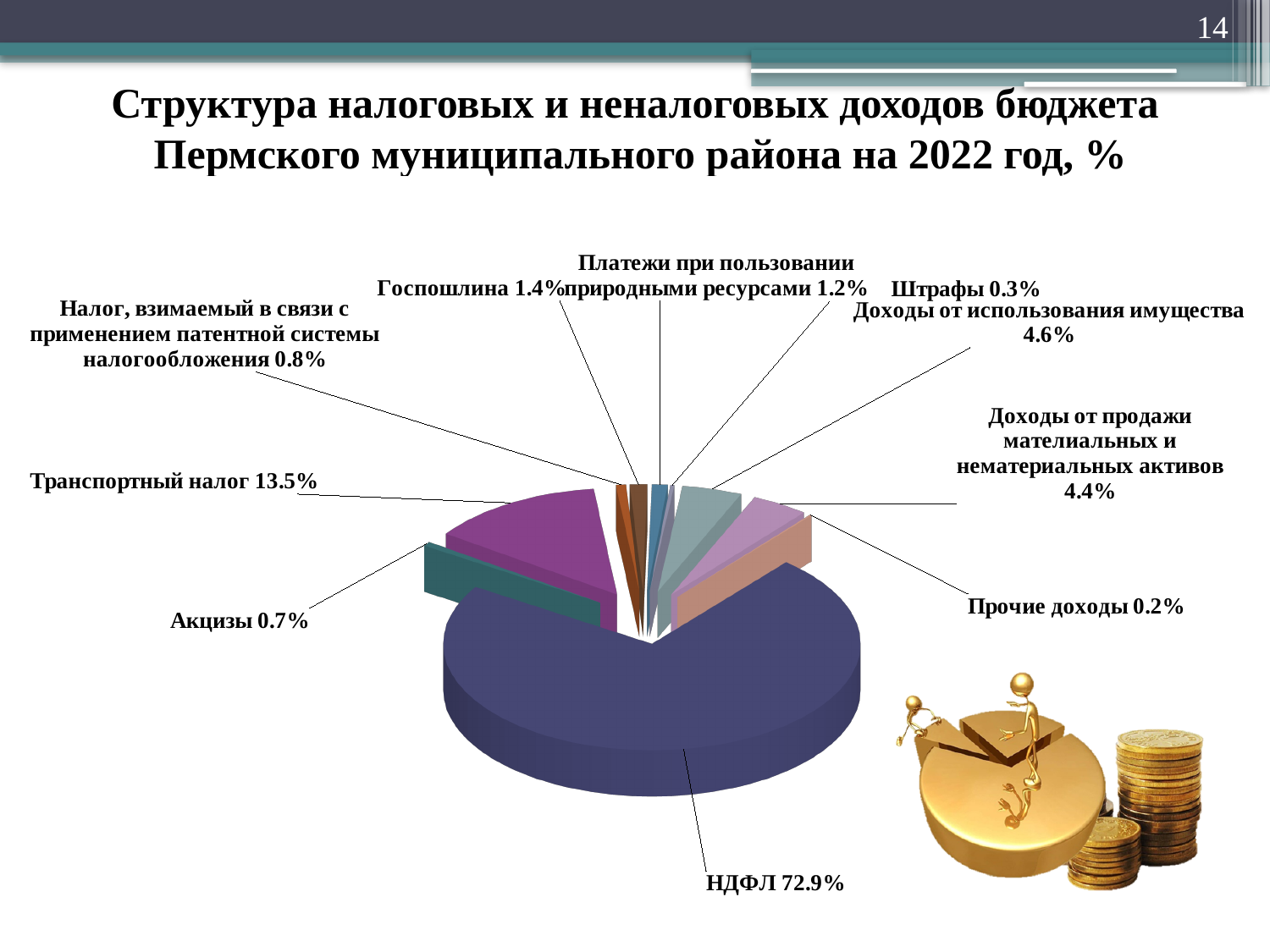
What is the difference in percentage points between НДФЛ and Транспортный налог? 59.4 What is the value for Госпошлина? 1.4% What percentage is shown for Доходы от использования имущества? 4.6% How many slices does the pie chart have? 10 What share is shown for Штрафы? 0.3% Which category has the smallest share of the pie? Прочие доходы What kind of chart is shown on the slide? Pie chart What is the value shown for Транспортный налог? 13.5% What share of the budget revenue does НДФЛ account for? 72.9% Which category has the largest share of the pie? НДФЛ What year does the chart title refer to? 2022 Which is larger: Доходы от использования имущества or Доходы от продажи мателиальных и нематериальных активов? Доходы от использования имущества